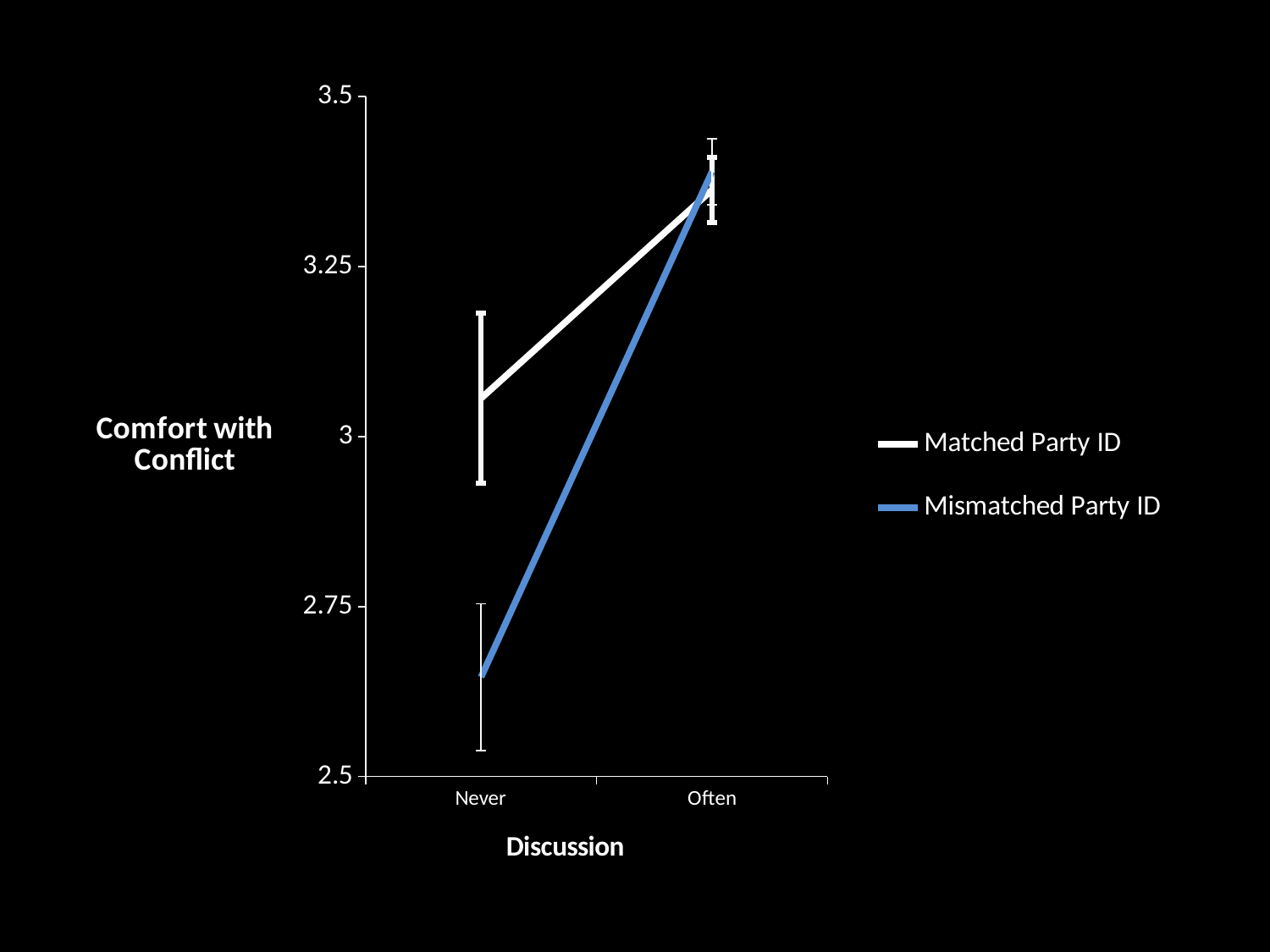
How many series does the legend list? 2 Is the value for Matched Party ID at Often greater or less than 3.5? less How many categories are shown on the x axis? 2 At Never, which series has the higher value, Matched Party ID or Mismatched Party ID? Matched Party ID Does the Matched Party ID line rise or fall from Never to Often? rise Is the value for Matched Party ID at Never greater or less than 3? greater Is the value for Mismatched Party ID at Never greater or less than 2.75? less What is the title of the vertical axis? Comfort with Conflict What kind of chart is shown on the slide? line chart Does the Mismatched Party ID line rise or fall from Never to Often? rise Which series is drawn in blue? Mismatched Party ID